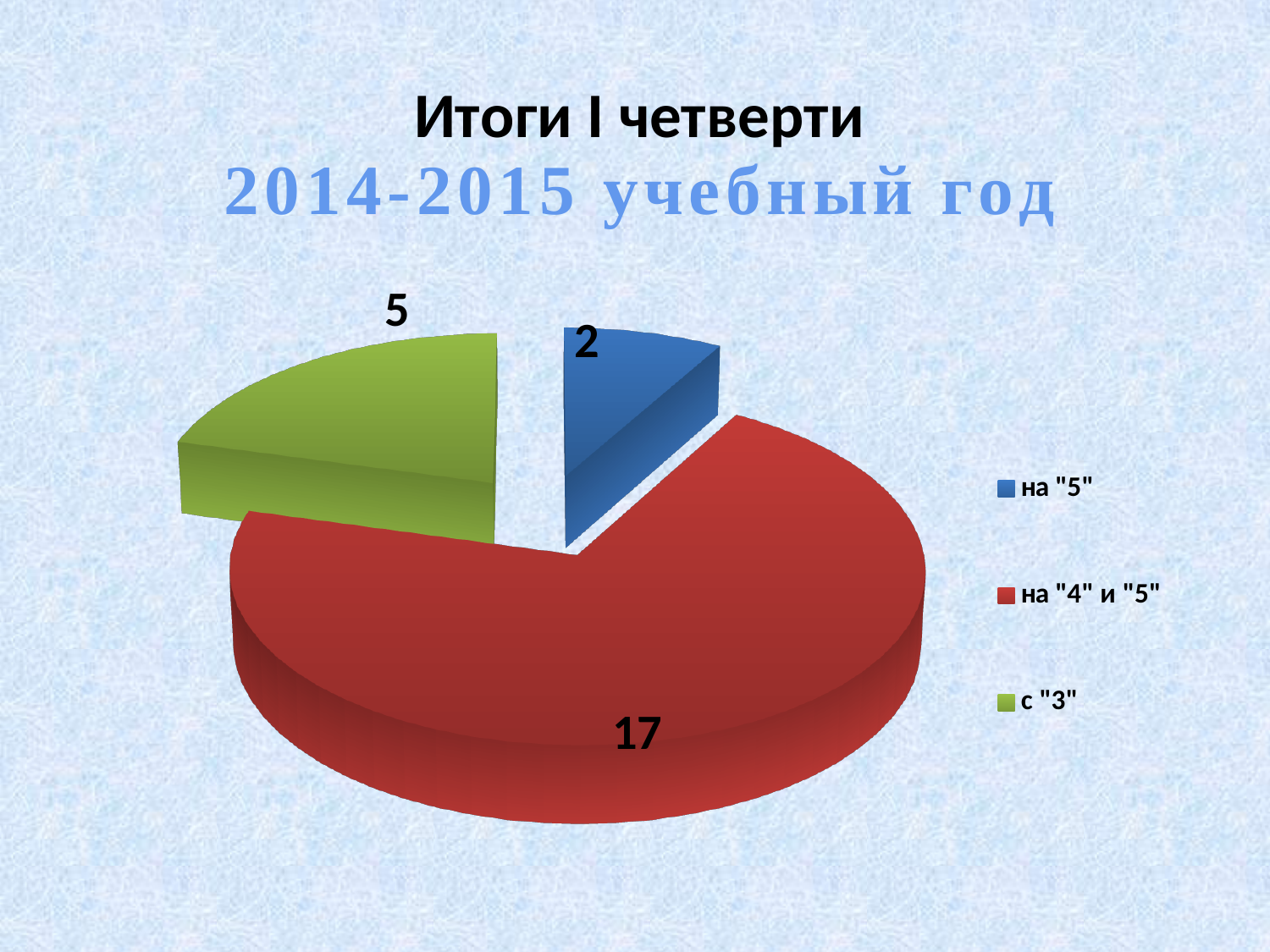
What kind of chart is shown on the slide? pie chart Which category has the largest slice of the pie? на "4" и "5" What is the difference between the values for с "3" and на "5"? 3 Which category has the smallest slice of the pie? на "5" What is the total of all the slice values in the pie chart? 24 What is the value for the slice labelled на "4" и "5"? 17 What is the difference between the values for на "4" и "5" and с "3"? 12 How many slices does the pie chart have? 3 Which is larger, the value for с "3" or the value for на "5"? с "3" What is the value for the slice labelled с "3"? 5 What colour is the slice for на "4" и "5"? red What is the value for the slice labelled на "5"? 2